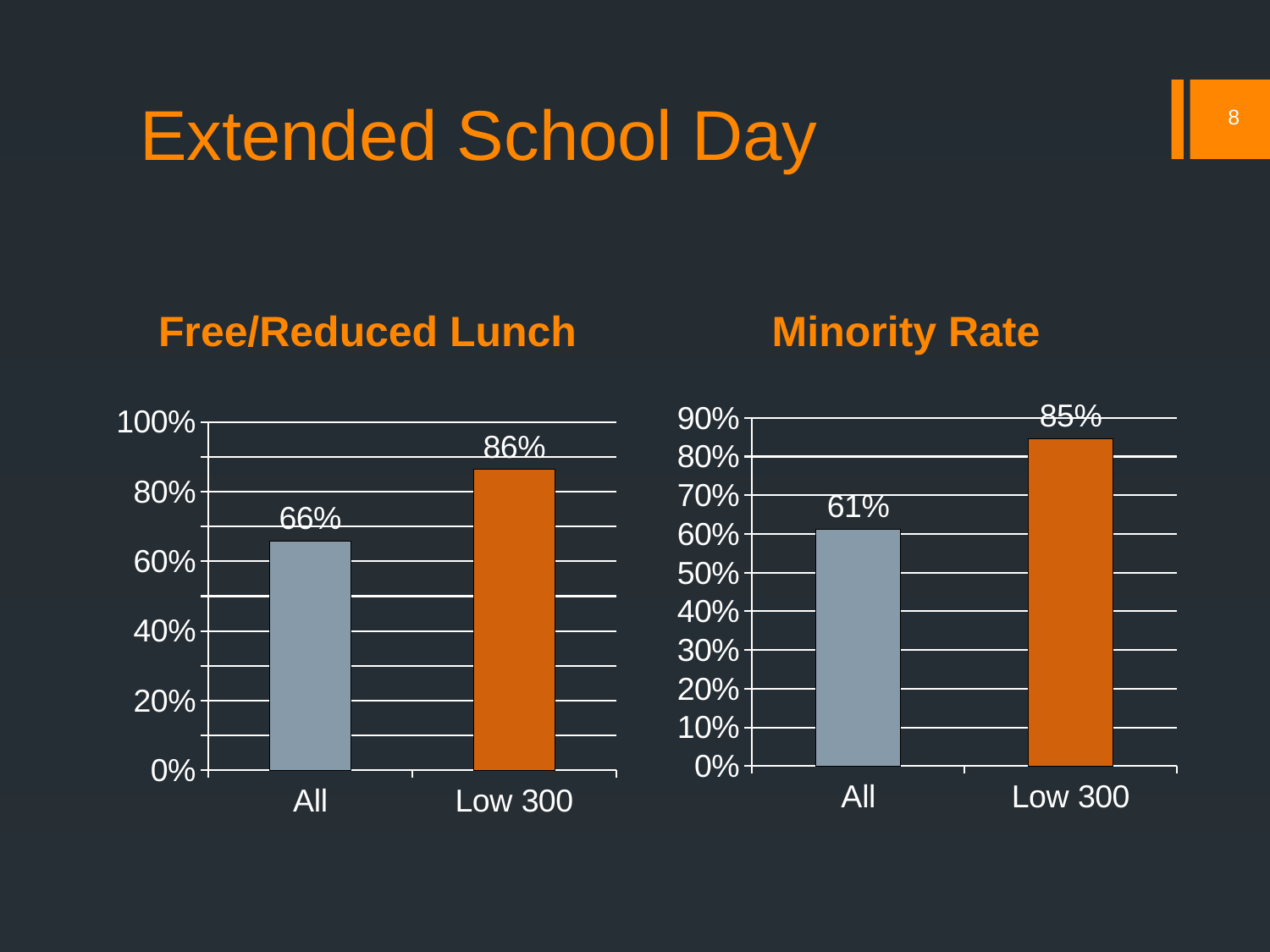
In the Free/Reduced Lunch chart, what is the value for All? 66% In the Free/Reduced Lunch chart, how many categories are shown on the x axis? 2 What kind of chart is the Minority Rate chart? Bar chart In the Minority Rate chart, which category has the lowest value? All In the Minority Rate chart, what is the value for Low 300? 85% In the Minority Rate chart, what is the value for All? 61% In the Free/Reduced Lunch chart, which category has the highest value? Low 300 In the Minority Rate chart, which is larger, the value for All or the value for Low 300? Low 300 In the Free/Reduced Lunch chart, what is the value for Low 300? 86% What is the title of the chart on the left side of the slide? Free/Reduced Lunch In the Free/Reduced Lunch chart, what is the difference between the Low 300 and All values? 20% In the Minority Rate chart, what is the difference between the Low 300 and All values? 24%